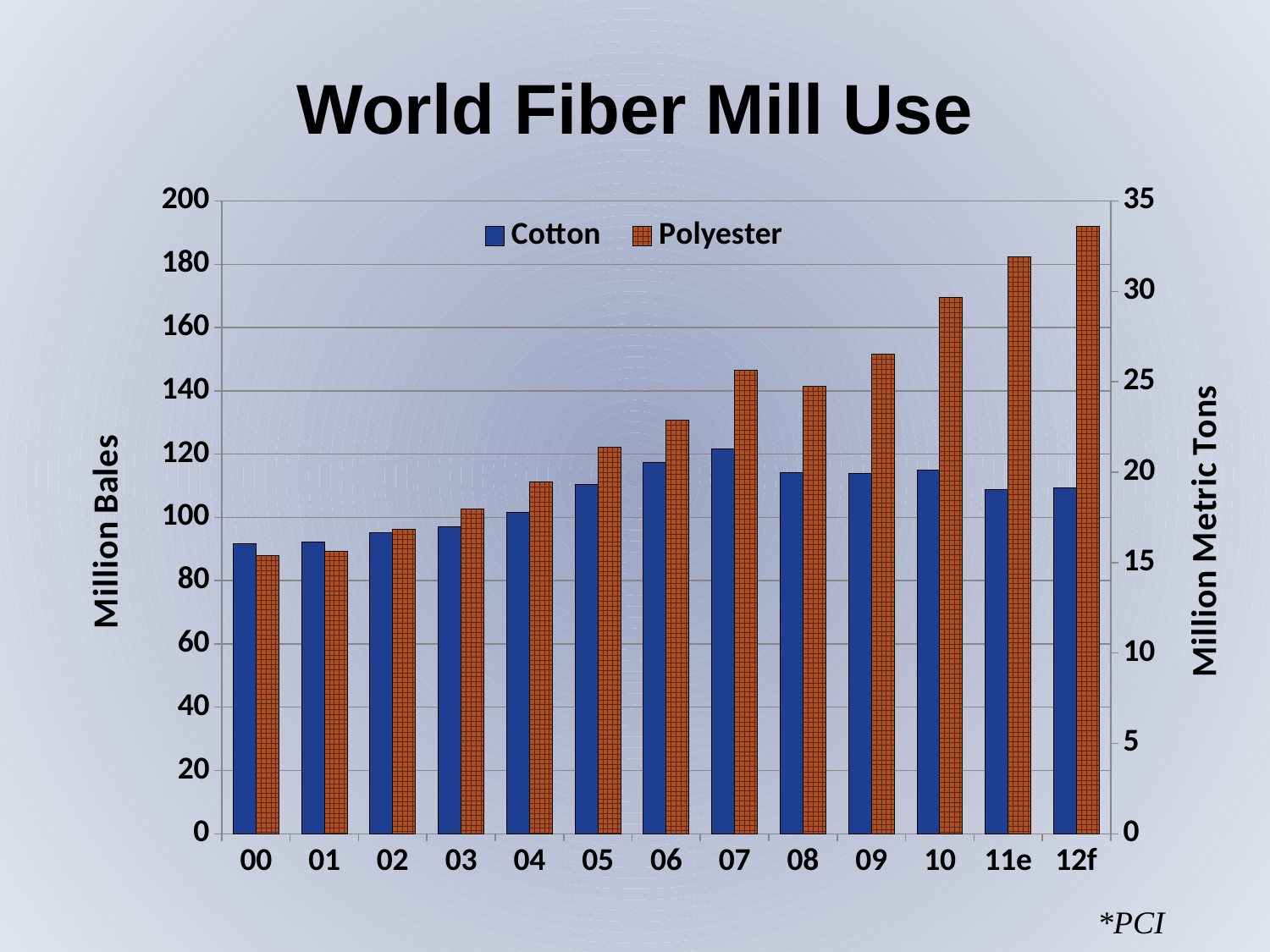
How many year categories are shown on the x axis? 13 What kind of chart is shown on the slide? bar chart Is the Polyester value for 12f greater or less than 30 million metric tons? greater What is the title of the left vertical axis? Million Bales What is the title of the right vertical axis? Million Metric Tons Is the Cotton value for 00 greater or less than 100 million bales? less In which year is the Cotton bar highest? 07 Is the Cotton value for 10 greater or less than 100 million bales? greater How many series does the legend list? 2 In which year is the Polyester bar highest? 12f Which is larger, the Cotton value for 07 or the Cotton value for 00? 07 Do the Polyester values generally rise or fall from 00 to 12f? rise